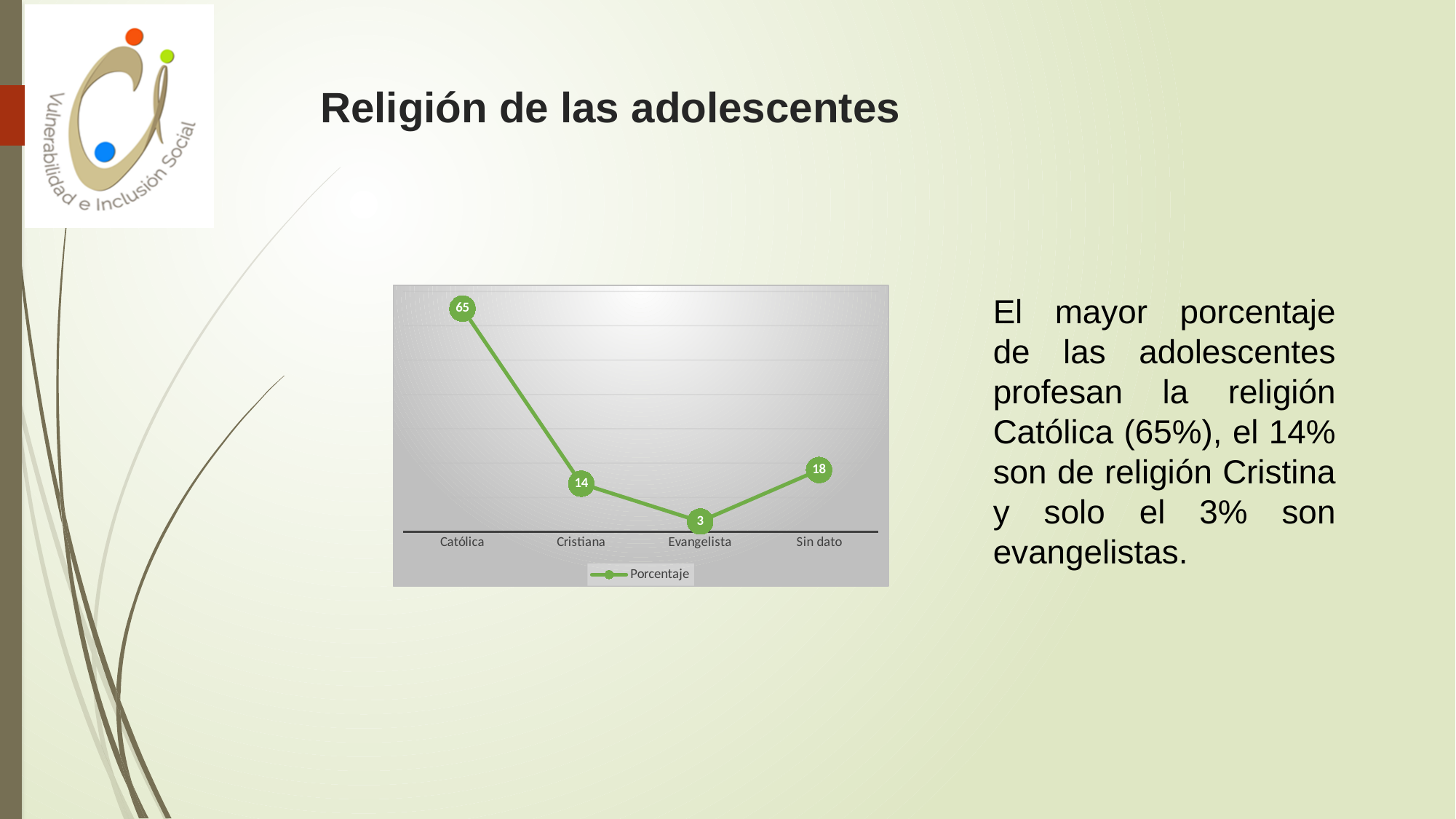
What is the difference between the values for Católica and Cristiana? 51 What is the value for Católica? 65 What series name does the legend show? Porcentaje Which category has the lowest value? Evangelista Which is larger, the value for Sin dato or the value for Cristiana? Sin dato What is the value for Cristiana? 14 What is the value for Sin dato? 18 What is the value for Evangelista? 3 What kind of chart is shown on the slide? Line chart How many categories are plotted on the chart? 4 Which category has the highest value? Católica What is the difference between the values for Sin dato and Evangelista? 15